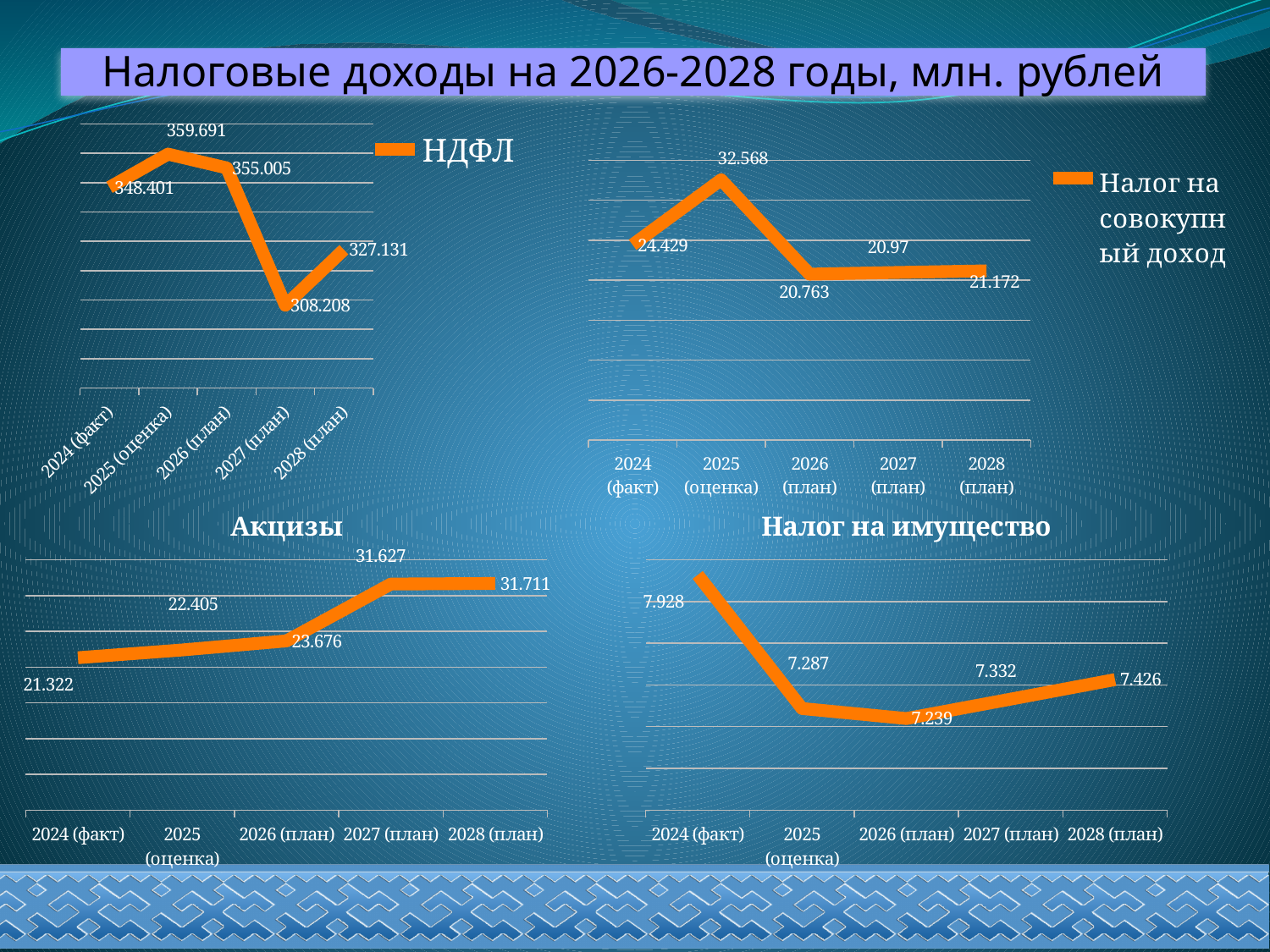
On the Акцизы chart, what is the value for 2028 (план)? 31.711 On the Акцизы chart, do the values rise or fall from 2024 (факт) to 2028 (план)? rise What type of chart is the Акцизы chart? line chart How many data points are plotted on the Налог на имущество chart? 5 On the НДФЛ chart, what is the difference between the 2026 (план) and 2027 (план) values? 46.797 On the Налог на имущество chart, what is the value for 2026 (план)? 7.239 On the Налог на совокупный доход chart, what is the value for 2024 (факт)? 24.429 On the НДФЛ chart, what is the value for 2025 (оценка)? 359.691 On the Налог на имущество chart, which is larger, the value for 2024 (факт) or the value for 2028 (план)? 2024 (факт) On the Налог на совокупный доход chart, which category has the highest value? 2025 (оценка) On the Акцизы chart, what is the difference between the 2027 (план) and 2026 (план) values? 7.951 On the НДФЛ chart, which category has the lowest value? 2027 (план)